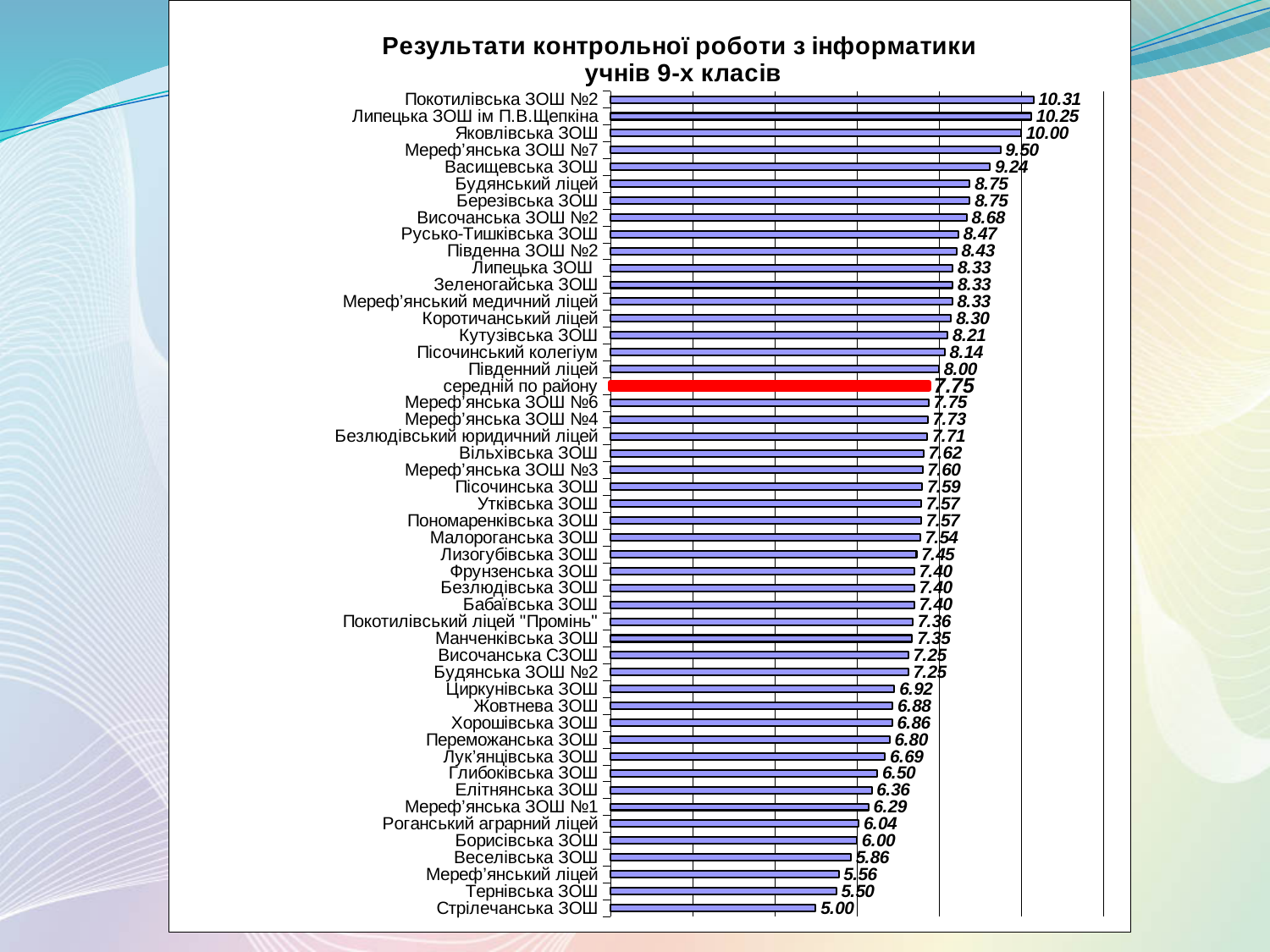
What kind of chart is shown on the slide? Bar chart Which is larger, the value for Васищевська ЗОШ or the value for Циркунівська ЗОШ? Васищевська ЗОШ Which category has the lowest value? Стрілечанська ЗОШ How many categories are plotted in the chart? 49 What is the value for Покотилівська ЗОШ №2? 10.31 What is the difference between the values for Покотилівська ЗОШ №2 and Стрілечанська ЗОШ? 5.31 What is the difference between the values for Яковлівська ЗОШ and Південний ліцей? 2.00 What is the value for середній по району? 7.75 What is the value for Кутузівська ЗОШ? 8.21 Which bar in the chart is coloured red? середній по району What is the value for Стрілечанська ЗОШ? 5.00 Which category has the highest value? Покотилівська ЗОШ №2